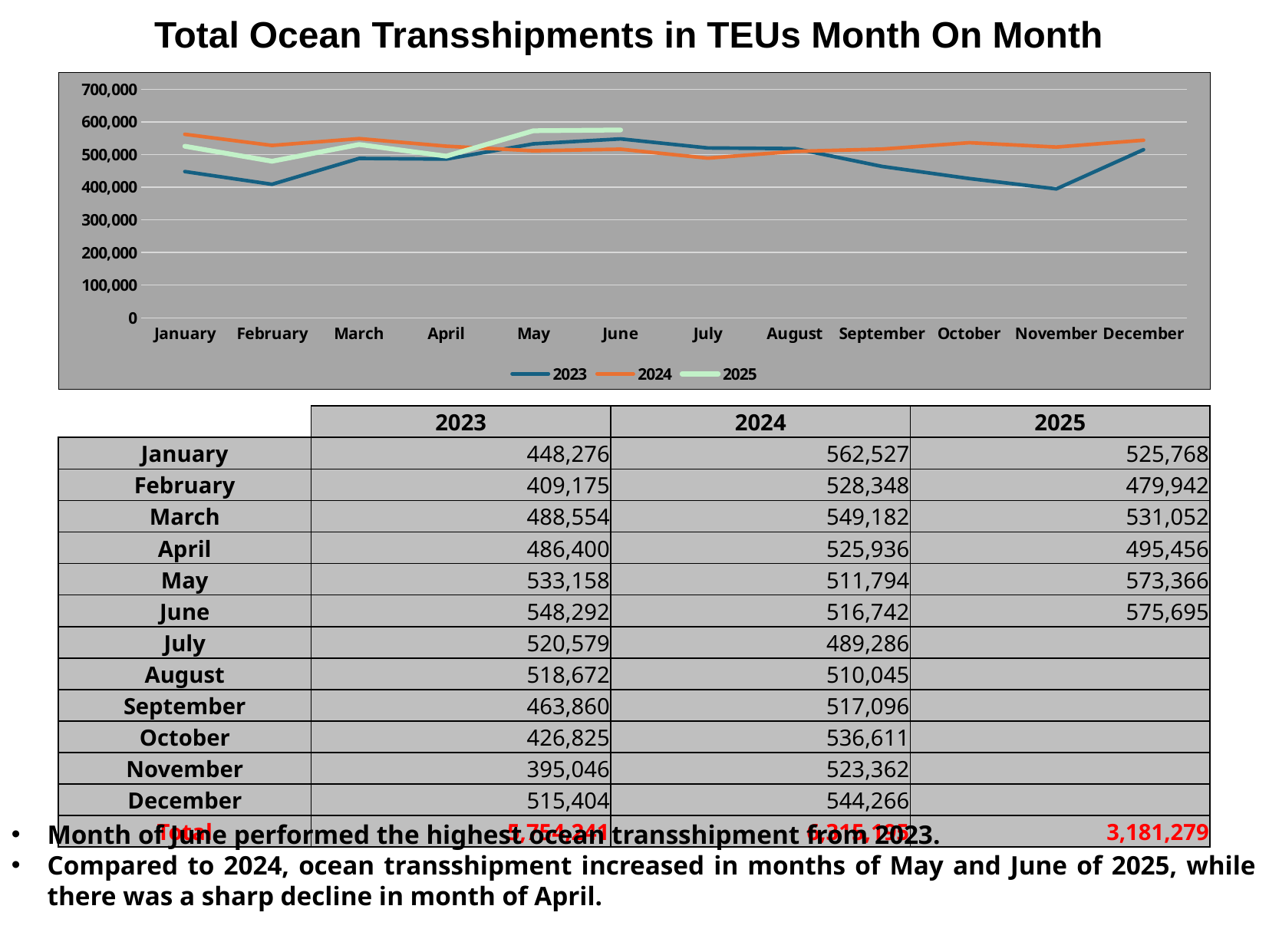
What kind of chart is shown on the slide? line chart What is the value for January in the 2023 series? 448,276 Is the value for February in the 2023 series greater or less than 500,000? less Does the 2023 series rise or fall from September to November? fall For January, which series has the larger value, 2023 or 2024? 2024 What is the difference between the 2025 and 2024 values for May? 61,572 How many series does the chart legend list? 3 How many months are shown along the x axis of the chart? 12 Which month has the lowest value in the 2023 series? November Which month has the highest value in the 2023 series? June What is the value for June in the 2025 series? 575,695 Which month has the lowest value in the 2024 series? July